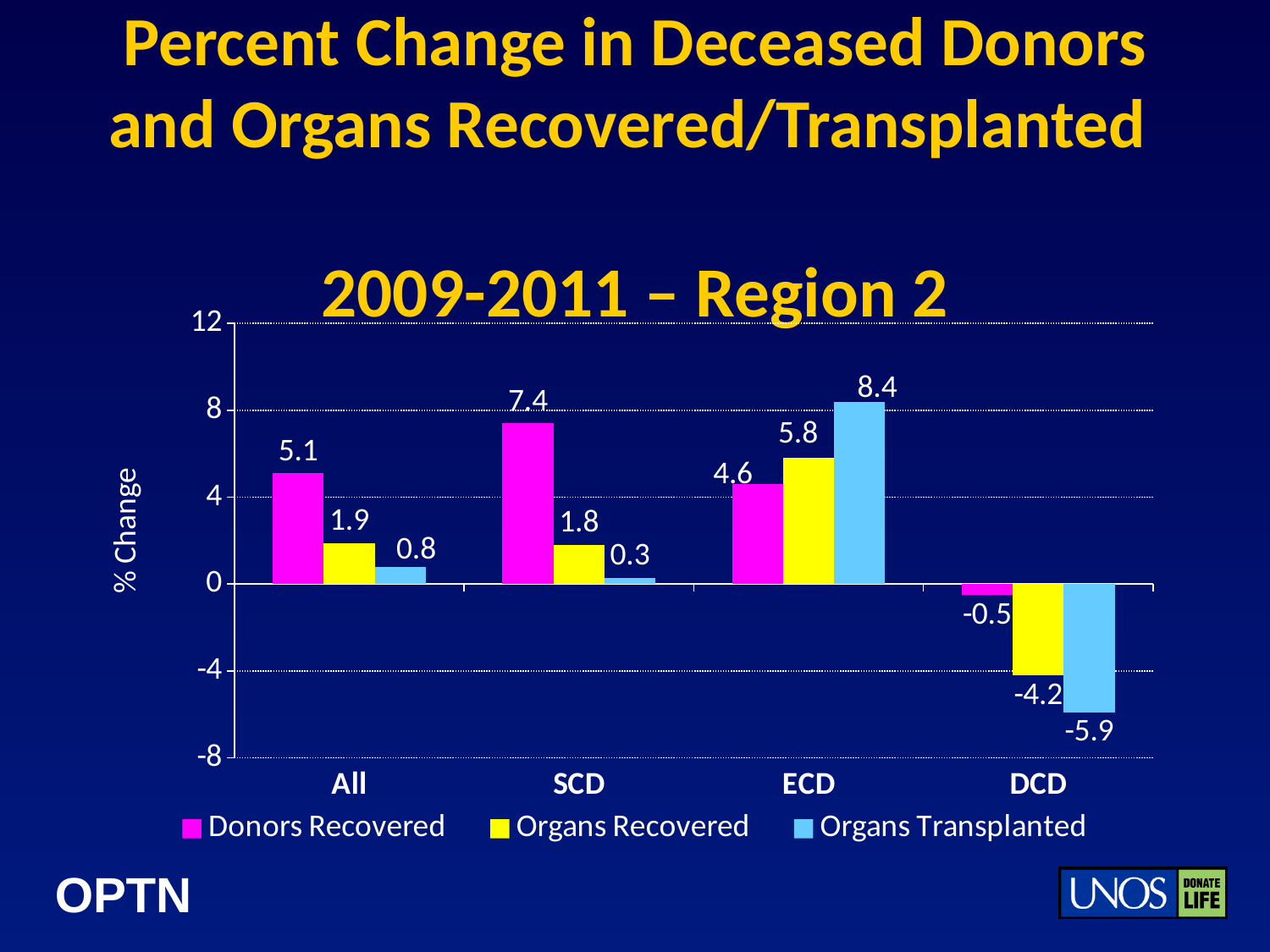
What is the value for Organs Transplanted in the ECD category? 8.4 What is the value for Donors Recovered in the SCD category? 7.4 How many categories are shown on the x axis? 4 What kind of chart is shown on the slide? Bar chart What is the label of the y axis? % Change What is the value for Organs Transplanted in the All category? 0.8 What is the difference between Donors Recovered and Organs Recovered in the All category? 3.2 Which is larger in the ECD category: Organs Recovered or Organs Transplanted? Organs Transplanted What is the value for Organs Recovered in the DCD category? -4.2 How many series does the legend list? 3 Which category has the highest value for Donors Recovered? SCD Which category has the lowest value for Organs Transplanted? DCD